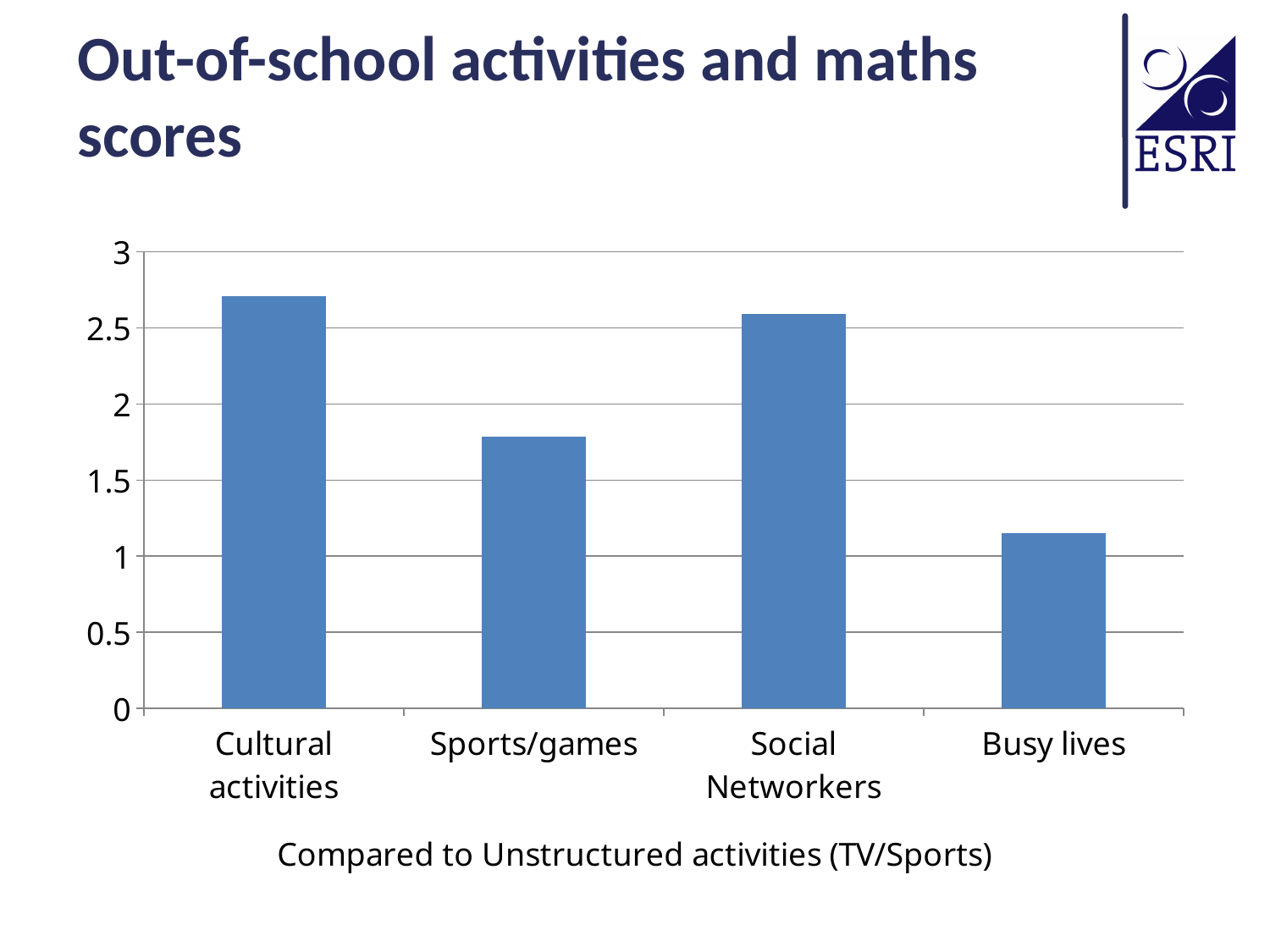
What kind of chart is shown on the slide? bar chart Is the value for Busy lives greater or less than 1? greater Is the value for Social Networkers greater or less than 2.5? greater Is the value for Cultural activities greater or less than 2.5? greater Which category has the highest value in the chart? Cultural activities Which category has the lowest value in the chart? Busy lives Which is larger, the value for Cultural activities or the value for Sports/games? Cultural activities Which is larger, the value for Sports/games or the value for Busy lives? Sports/games How many categories are shown on the x axis of the chart? 4 What is the x-axis title of the chart? Compared to Unstructured activities (TV/Sports)